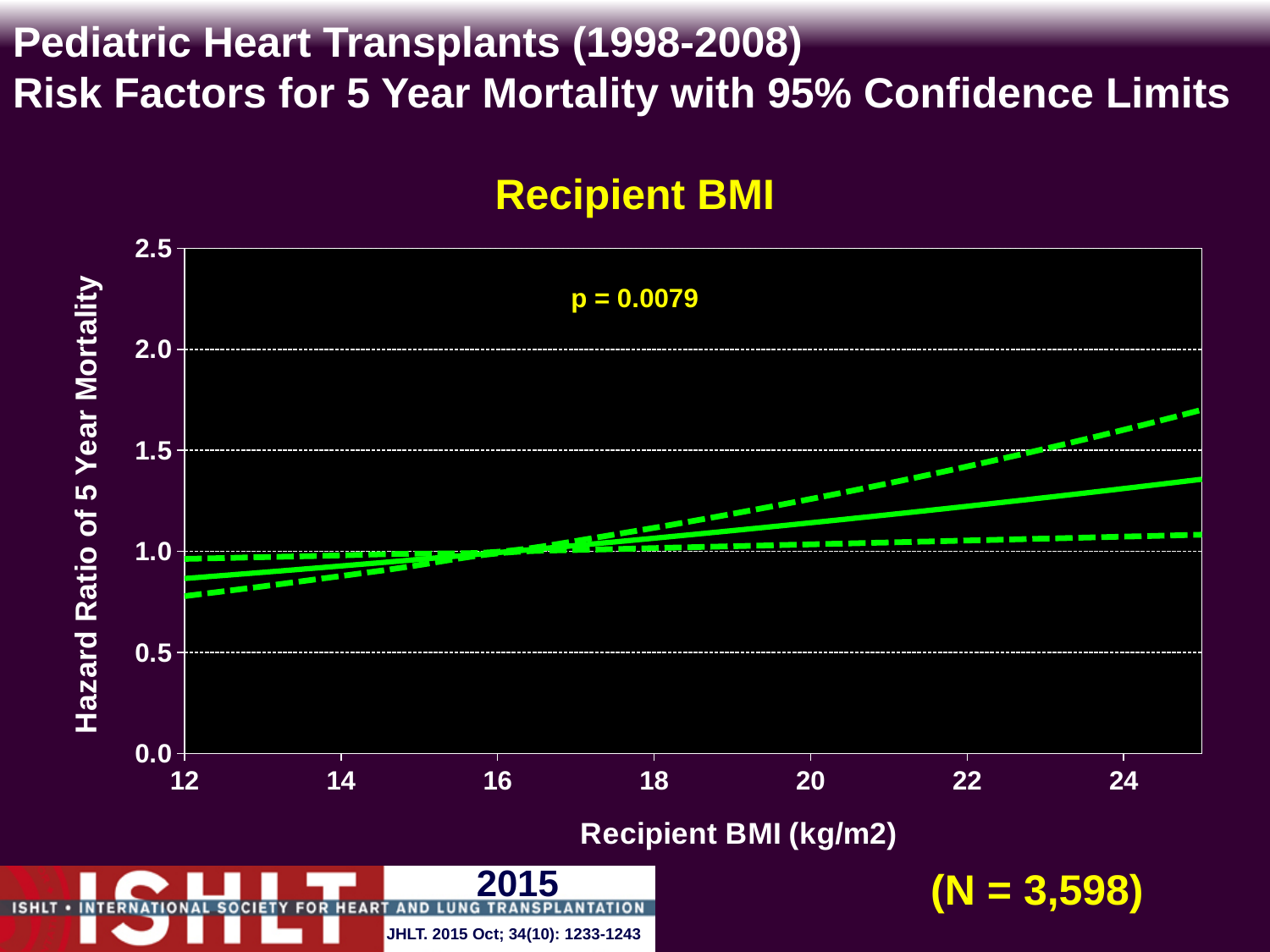
Is the hazard ratio (solid line) at a Recipient BMI of 24 greater or less than 1.5? less Is the upper confidence limit (upper dashed line) at a Recipient BMI of 24 greater or less than 1.5? greater What is the label of the y axis? Hazard Ratio of 5 Year Mortality Is the hazard ratio (solid line) at a Recipient BMI of 12 greater or less than 1.0? less How many lines are plotted on the chart? 3 What is the highest value shown on the y axis? 2.5 What kind of chart is shown on the slide? line chart Does the solid hazard ratio line rise or fall as Recipient BMI increases from 12 to 24? rise What is the title of the chart? Recipient BMI